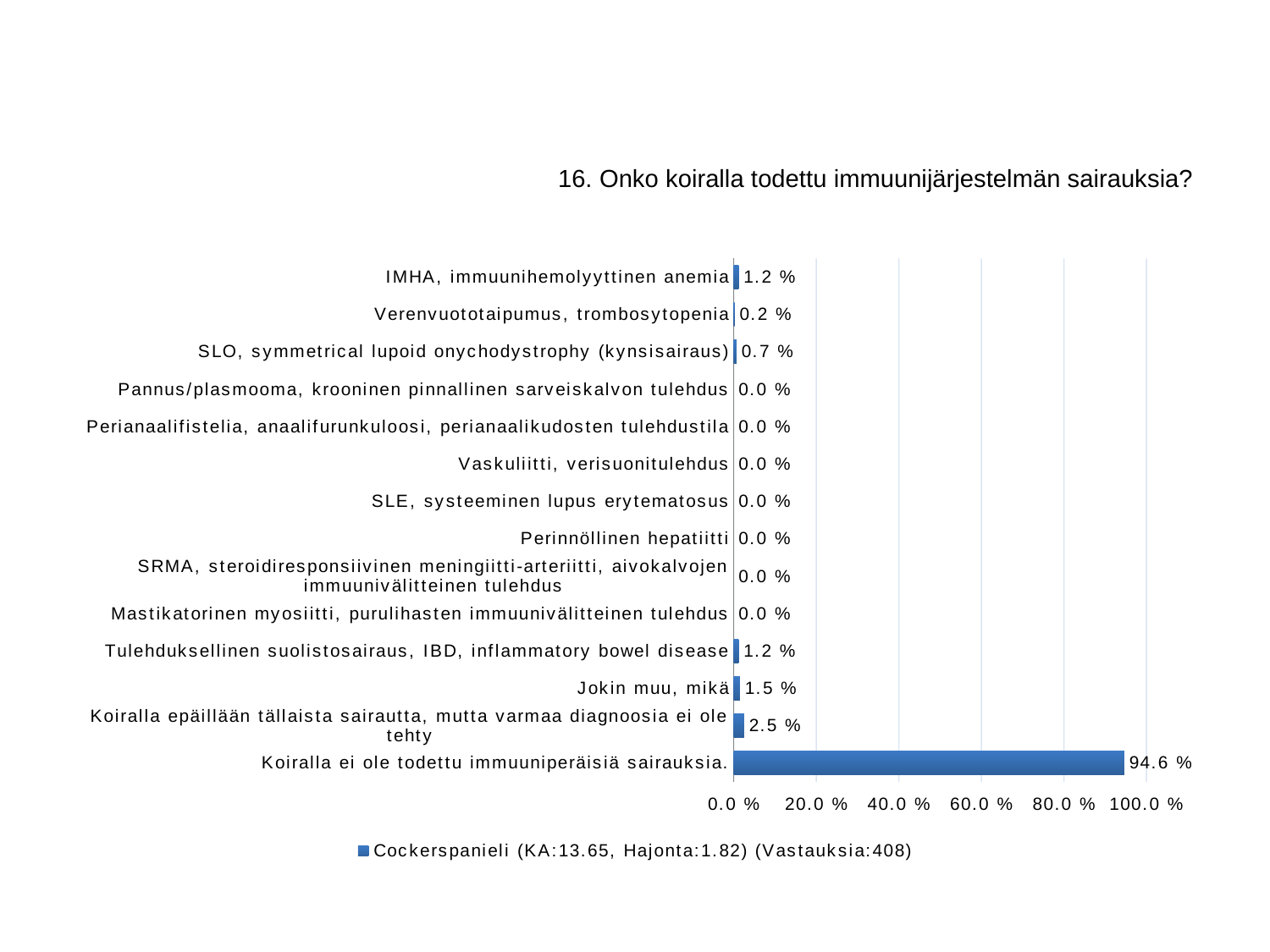
Which category has the highest value? Koiralla ei ole todettu immuuniperäisiä sairauksia. What kind of chart is shown on the slide? bar chart What is the value for "SLO, symmetrical lupoid onychodystrophy (kynsisairaus)"? 0.7 % What is the difference between the values for "Koiralla epäillään tällaista sairautta, mutta varmaa diagnoosia ei ole tehty" and "Jokin muu, mikä"? 1.0 % How many series does the legend list? 1 What is the value for "IMHA, immuunihemolyyttinen anemia"? 1.2 % Which is larger: the value for "Verenvuototaipumus, trombosytopenia" or the value for "SLO, symmetrical lupoid onychodystrophy (kynsisairaus)"? SLO, symmetrical lupoid onychodystrophy (kynsisairaus) Is the value for "Koiralla ei ole todettu immuuniperäisiä sairauksia." greater or less than 80.0 %? greater How many categories are shown in the chart? 14 What is the value for "Koiralla ei ole todettu immuuniperäisiä sairauksia."? 94.6 % What is the value for "Jokin muu, mikä"? 1.5 % What is the title of the chart? 16. Onko koiralla todettu immuunijärjestelmän sairauksia?